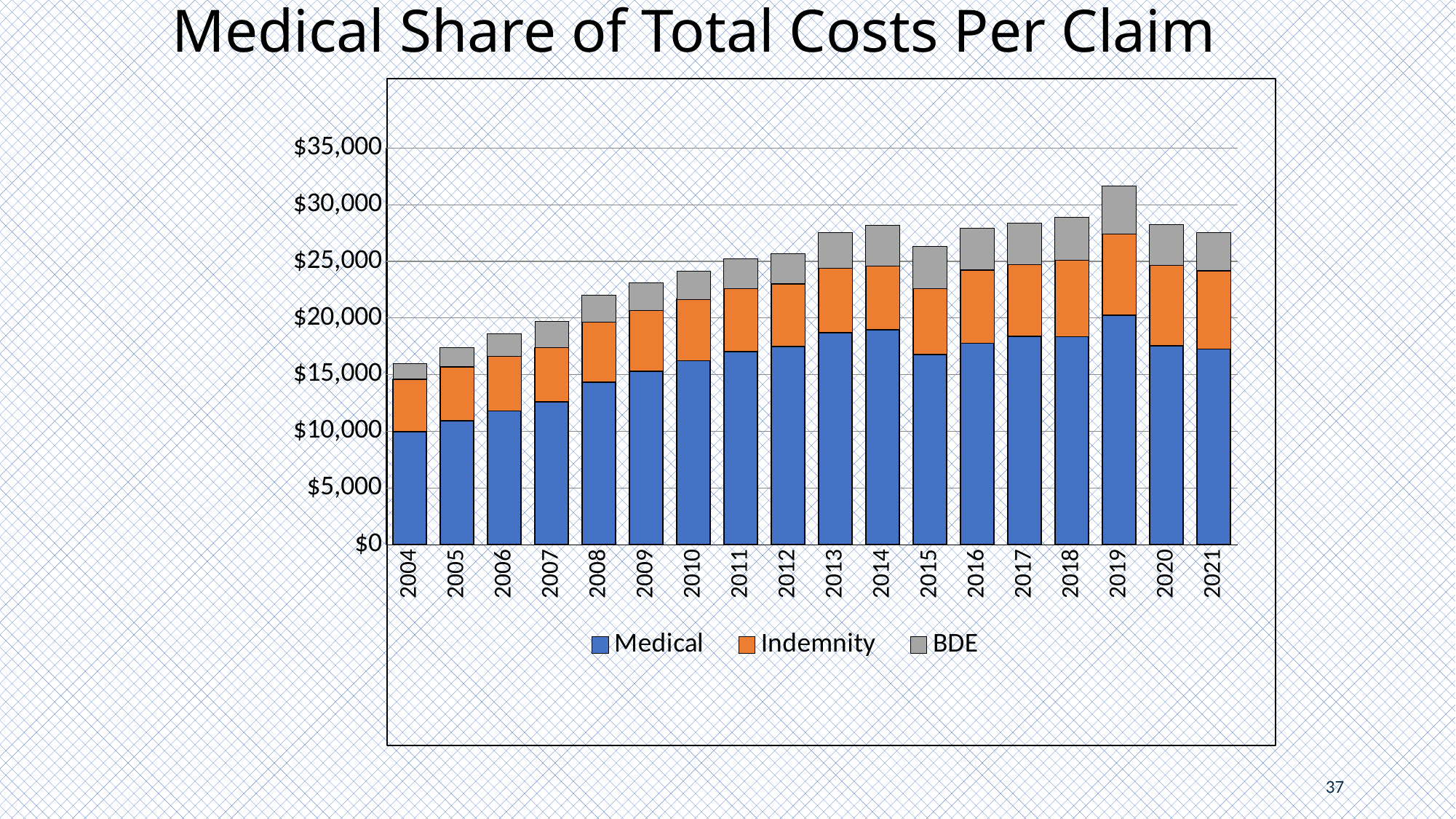
Is the total cost per claim for 2019 greater or less than $30,000? greater Which is larger, the Medical value for 2019 or for 2020? 2019 Which series is shown in grey in the legend? BDE Which year has the highest total cost per claim? 2019 Which year has the highest Medical value? 2019 How many series does the legend list? 3 Is the total cost per claim for 2004 greater or less than $20,000? less Does the Medical value rise or fall from 2004 to 2013? rise How many years are shown on the x axis? 18 Which year has the lowest total cost per claim? 2004 What kind of chart is shown on the slide? Stacked bar chart Is the Medical value for 2008 greater or less than $15,000? less